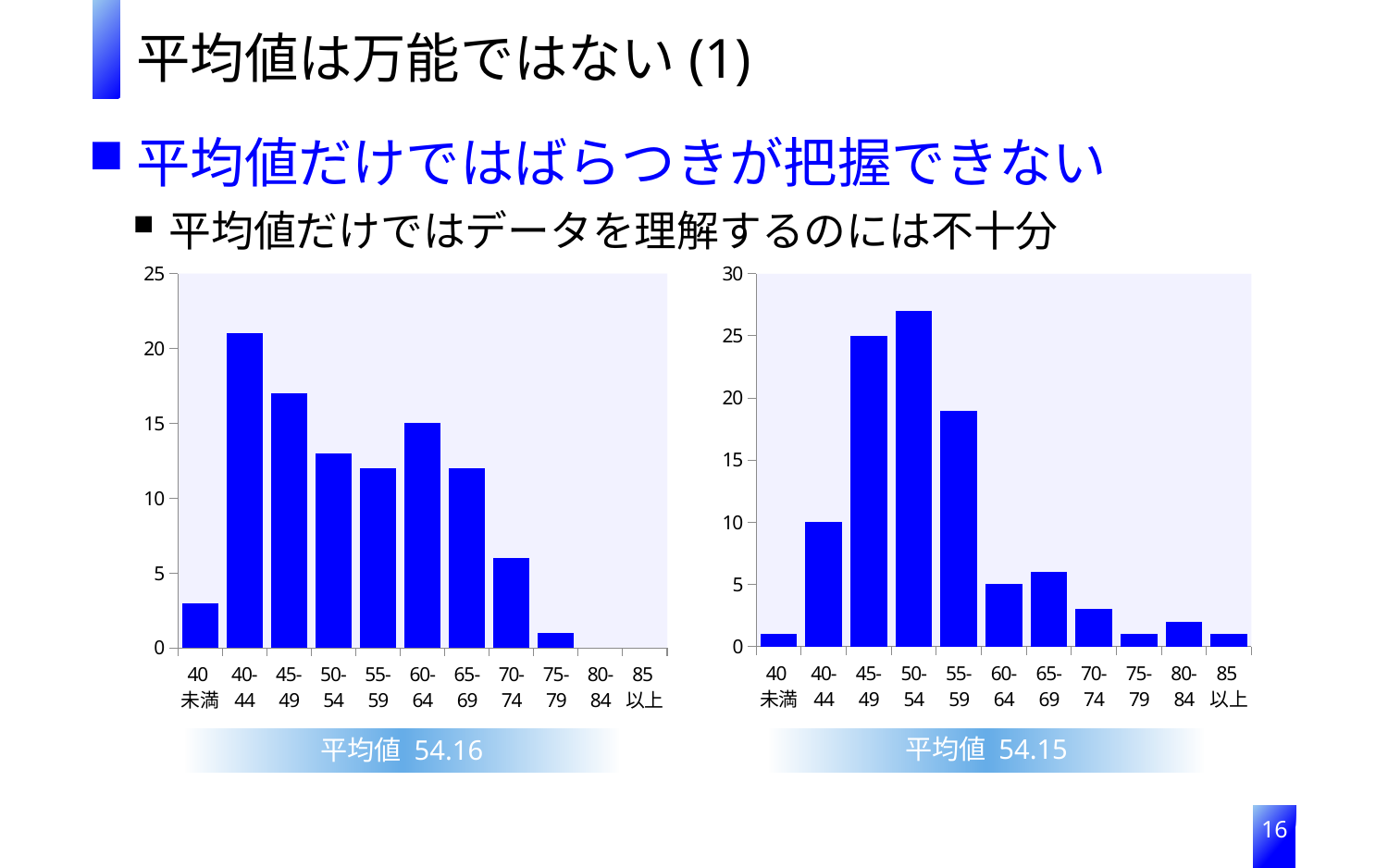
In the right chart, what is the value for the 40-44 category? 10 In the right chart, is the value for 55-59 greater or less than 15? greater In the right chart, which category has the highest bar? 50-54 In the left chart, which category has the highest bar? 40-44 In the right chart, what is the value for the 45-49 category? 25 In the left chart, what is the value for the 60-64 category? 15 In the right chart, what is the value for the 60-64 category? 5 In the left chart, is the value for 40-44 greater or less than 20? greater In the left chart, which is larger, the value for 45-49 or the value for 50-54? 45-49 What mean value (平均値) is shown below the right chart? 54.15 What kind of chart is the left chart on the slide? bar chart How many categories are shown on the x axis of the right chart? 11